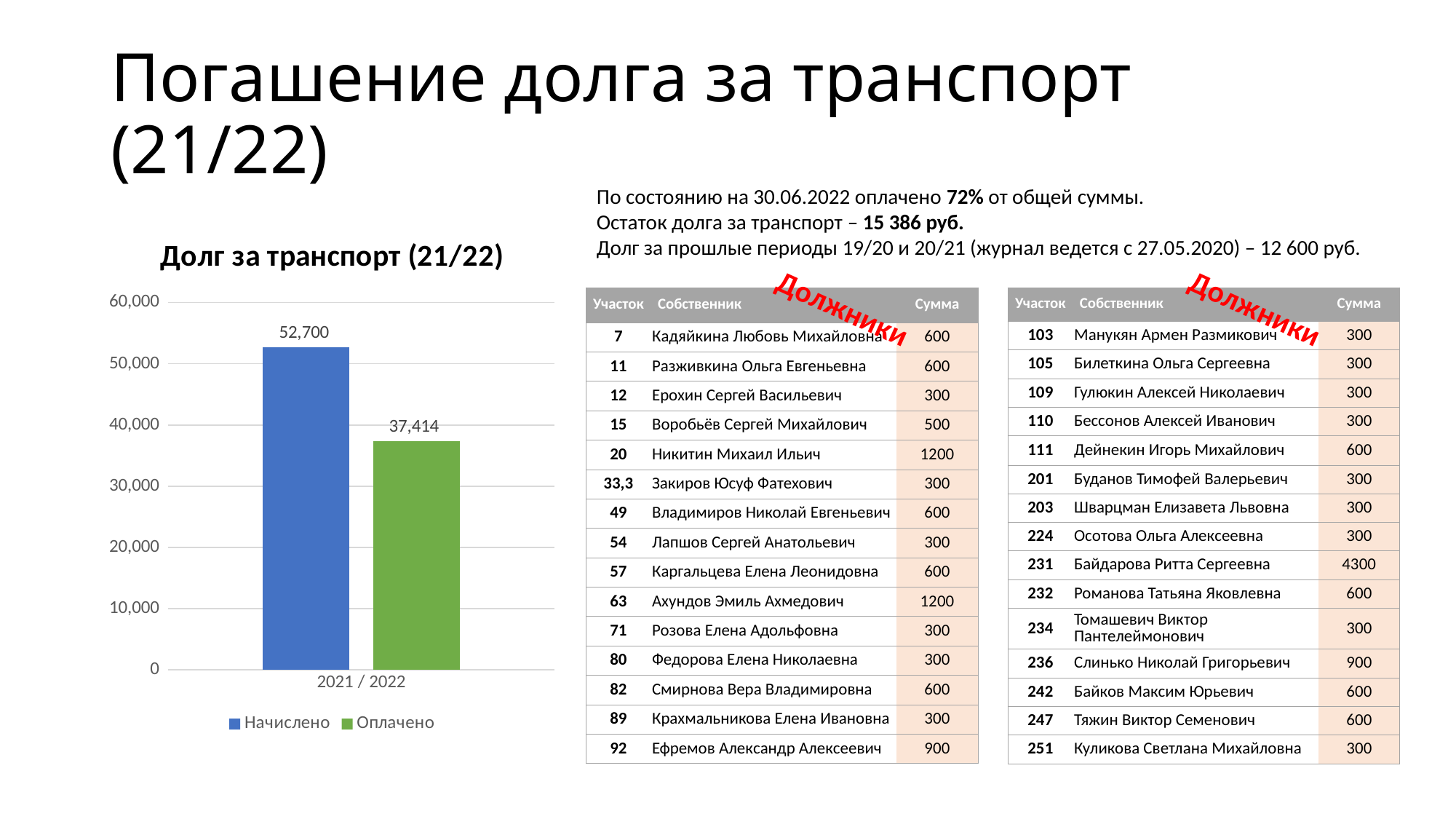
Is the value for Оплачено greater or less than 40,000? less Is the value for Начислено greater or less than 50,000? greater What is the difference between the Начислено and Оплачено values? 15,286 What is the value of the Начислено bar for 2021 / 2022? 52,700 How many categories are shown on the x axis of the chart? 1 What is the title of the chart? Долг за транспорт (21/22) Which series has the higher value in the chart, Начислено or Оплачено? Начислено What is the value of the Оплачено bar for 2021 / 2022? 37,414 How many series does the chart legend list? 2 Which series has the highest bar in the chart? Начислено What type of chart is shown on the slide? bar chart Which series has the lowest bar in the chart? Оплачено